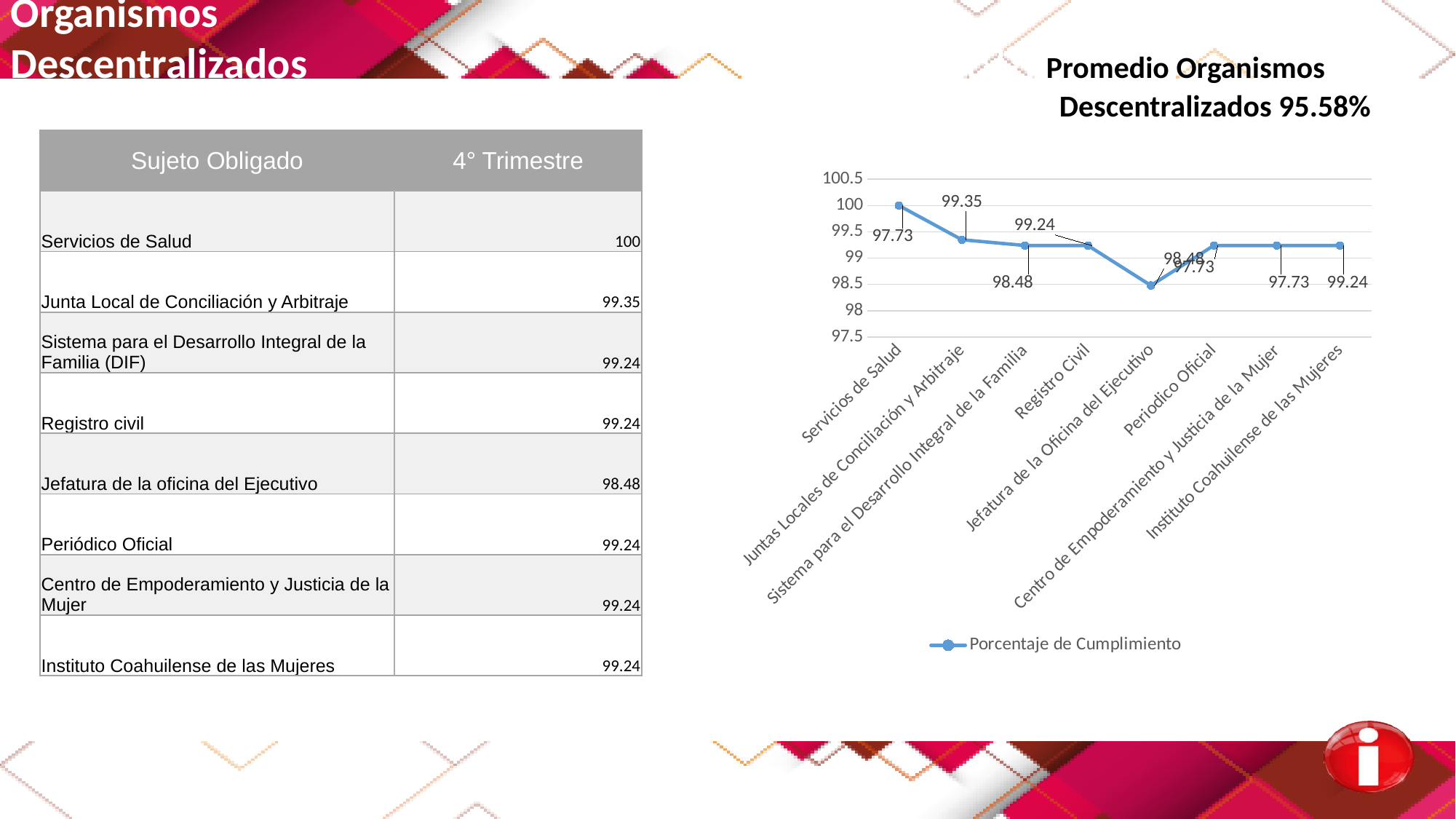
What is the value for Jefatura de la Oficina del Ejecutivo in the chart? 98.48 Do the values rise or fall from Servicios de Salud to Jefatura de la Oficina del Ejecutivo? fall What kind of chart is shown on the slide? line chart Is the value for Registro Civil greater or less than 99? greater How many series does the chart legend list? 1 Which is larger, the value for Servicios de Salud or the value for Jefatura de la Oficina del Ejecutivo? Servicios de Salud Which category has the highest value in the chart? Servicios de Salud What is the name of the series shown in the chart legend? Porcentaje de Cumplimiento What is the value for Juntas Locales de Conciliación y Arbitraje in the chart? 99.35 Which category has the lowest value in the chart? Jefatura de la Oficina del Ejecutivo What is the value for Servicios de Salud in the chart? 100 How many categories are plotted along the x axis of the chart? 8